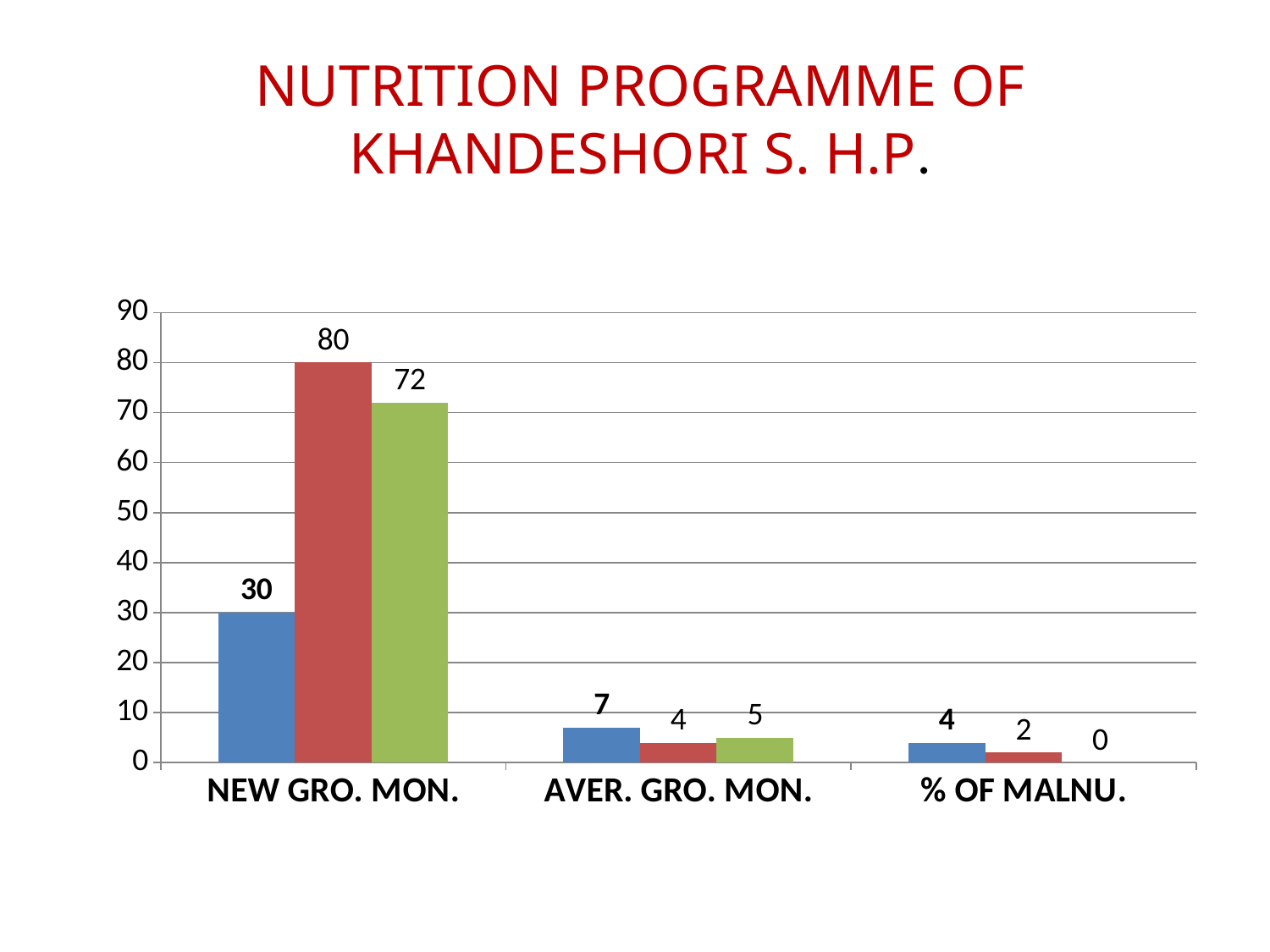
Which category has the highest bar on the chart? NEW GRO. MON. What is the difference between the red and green bars for NEW GRO. MON.? 8 What is the value of the green bar for AVER. GRO. MON.? 5 What type of chart is shown on the slide? Bar chart Which is larger for AVER. GRO. MON., the blue bar or the red bar? The blue bar How many categories are shown on the x axis? 3 How many bars are shown for each category? 3 What is the value of the blue bar for NEW GRO. MON.? 30 Which bar in the NEW GRO. MON. group has the lowest value? The blue bar (30) What is the value of the red bar for NEW GRO. MON.? 80 What is the value of the green bar for % OF MALNU.? 0 What is the title of the slide containing the chart? NUTRITION PROGRAMME OF KHANDESHORI S. H.P.